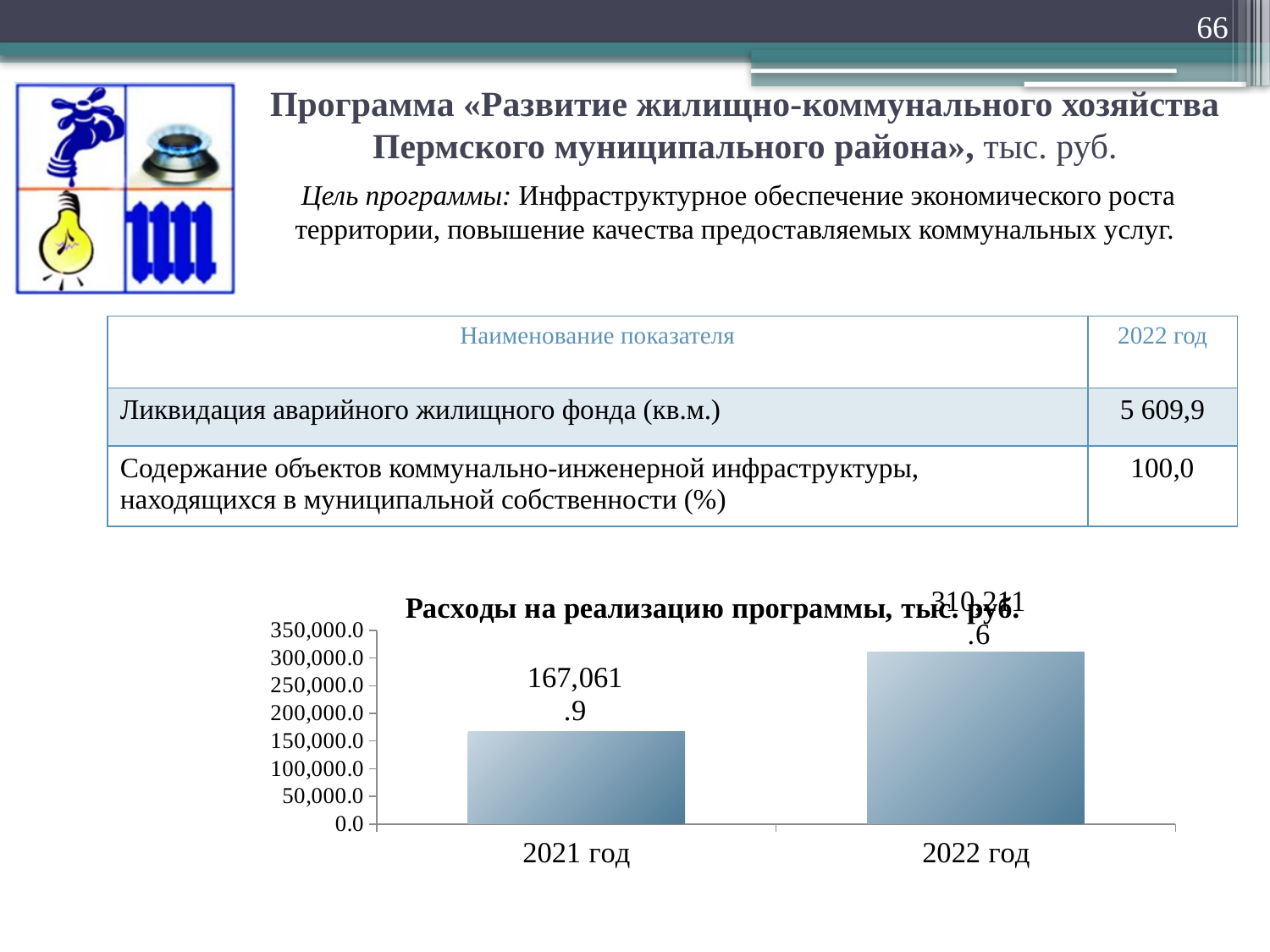
What kind of chart is shown on the slide? bar chart How many categories are shown on the x axis of the chart? 2 What is the value for 2021 год in the chart? 167,061.9 Which is larger, the value for 2021 год or the value for 2022 год? 2022 год Is the value for 2021 год greater or less than 200,000.0? less Do the values rise or fall from 2021 год to 2022 год? rise What is the title of the chart? Расходы на реализацию программы, тыс. руб. What is the difference between the values for 2022 год and 2021 год? 143,149.7 What is the value for 2022 год in the chart? 310,211.6 Which year has the highest value in the chart? 2022 год Which year has the lowest value in the chart? 2021 год Is the value for 2022 год greater or less than 300,000.0? greater